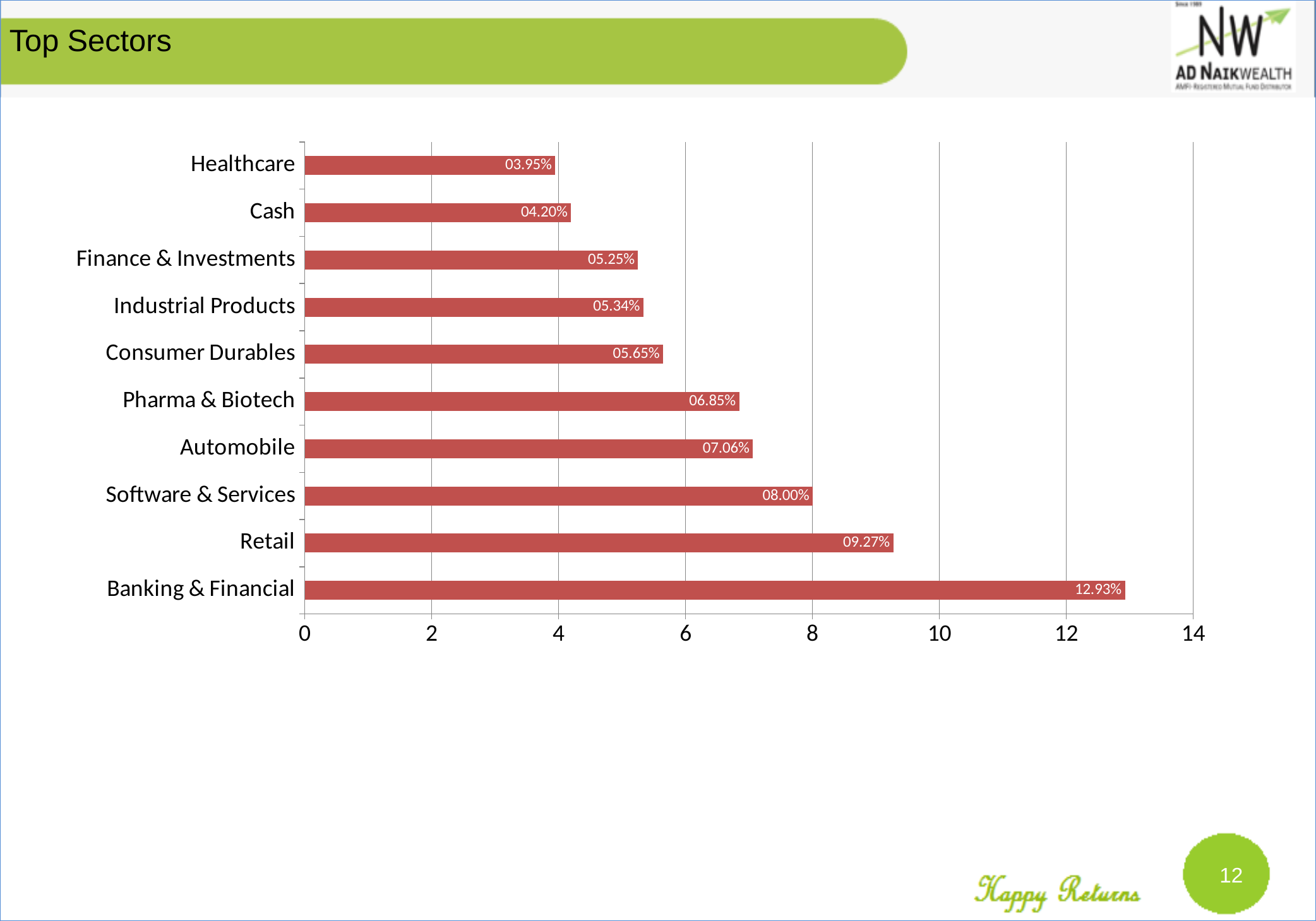
Which sector has the lowest value? Healthcare What is the difference between the values for Software & Services and Automobile? 0.94% What is the value for Healthcare? 03.95% What kind of chart is shown on the slide? Bar chart What is the value for Banking & Financial? 12.93% What is the title of the slide? Top Sectors How many sectors are shown in the chart? 10 Which is larger, the value for Consumer Durables or the value for Cash? Consumer Durables Which sector has the highest value? Banking & Financial What is the value for Pharma & Biotech? 06.85% What is the value for Retail? 09.27% What is the difference between the values for Banking & Financial and Retail? 3.66%